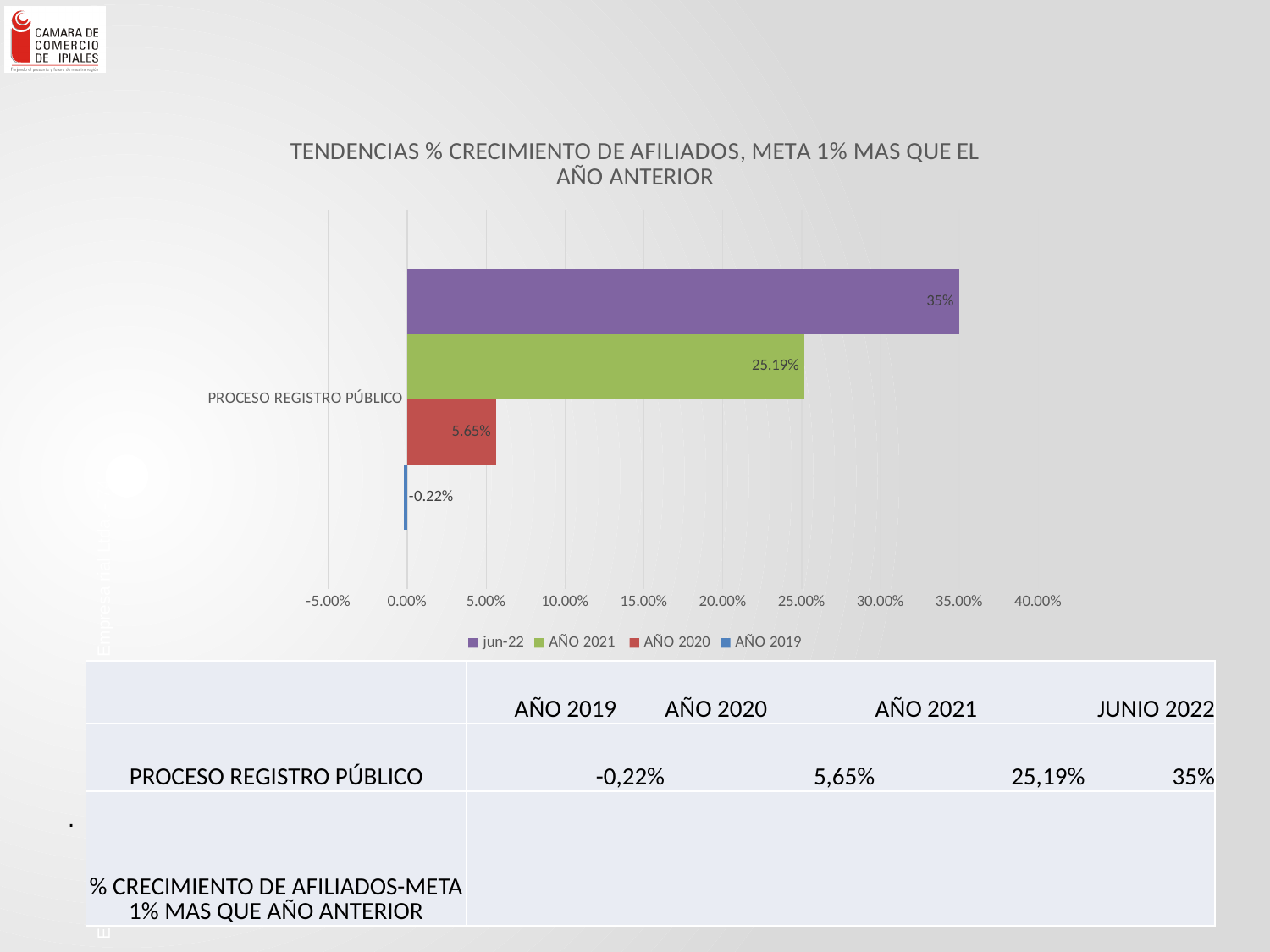
What is the difference between the jun-22 value and the AÑO 2021 value? 9.81% What is the value for the AÑO 2019 series in the chart? -0.22% Which series has the highest value in the chart? jun-22 What is the title of the chart? TENDENCIAS % CRECIMIENTO DE AFILIADOS, META 1% MAS QUE EL AÑO ANTERIOR What is the value for the jun-22 series in the chart? 35% What is the value for the AÑO 2020 series in the chart? 5.65% Which series has the lowest value in the chart? AÑO 2019 How many series does the legend list? 4 Which is larger, the value for AÑO 2020 or the value for AÑO 2021? AÑO 2021 What is the name of the single category shown on the chart's vertical axis? PROCESO REGISTRO PÚBLICO What is the value for the AÑO 2021 series in the chart? 25.19% What kind of chart is shown on the slide? Bar chart